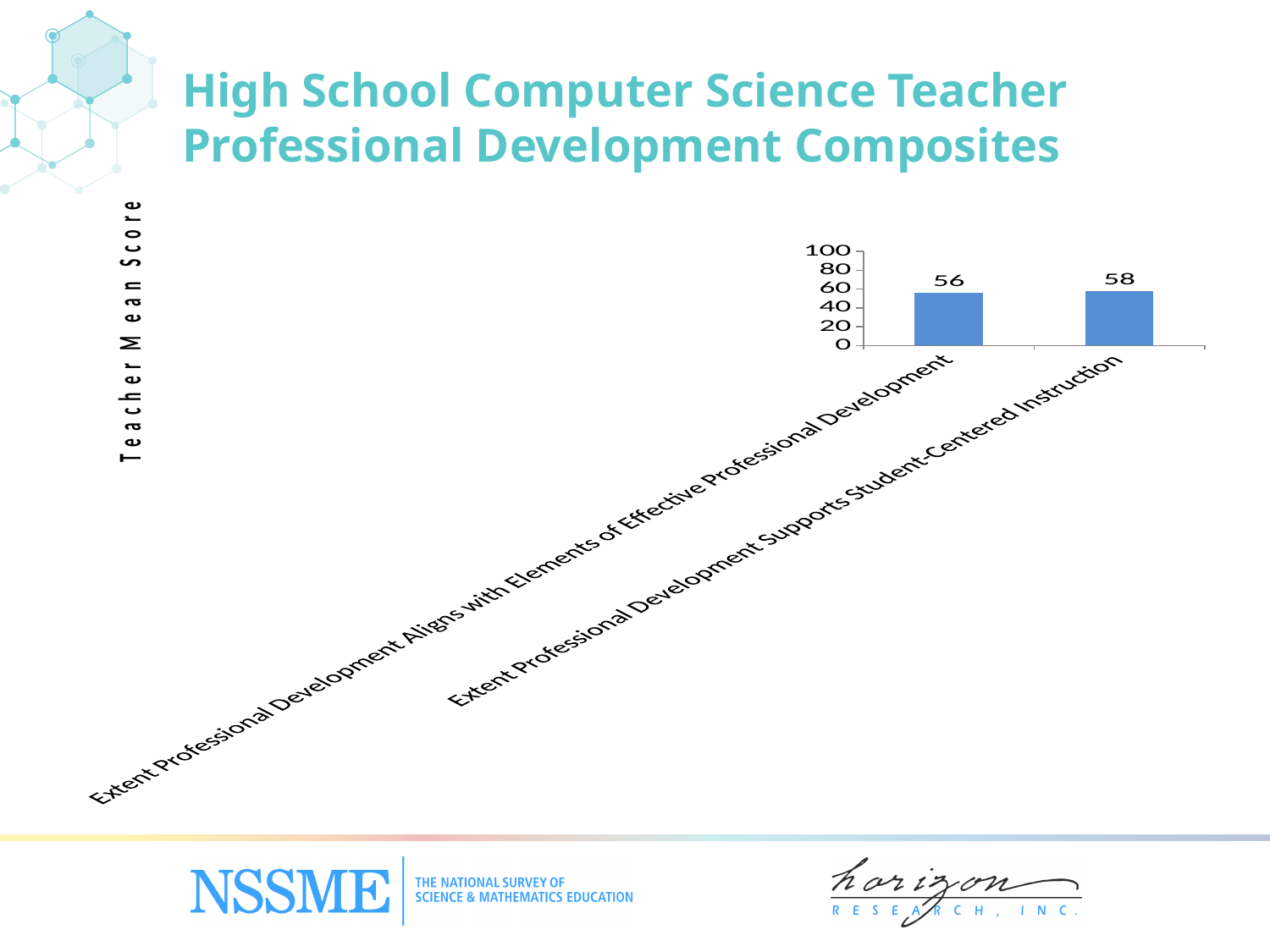
Is the value for 'Extent Professional Development Aligns with Elements of Effective Professional Development' greater or less than 60? less What is the difference between the teacher mean scores of the two composites? 2 What kind of chart is shown on the slide? Bar chart Which composite has the higher teacher mean score? Extent Professional Development Supports Student-Centered Instruction What is the teacher mean score for 'Extent Professional Development Aligns with Elements of Effective Professional Development'? 56 Is the value for 'Extent Professional Development Supports Student-Centered Instruction' greater or less than 40? greater How many composites (categories) are plotted in the chart? 2 Which composite has the lower teacher mean score? Extent Professional Development Aligns with Elements of Effective Professional Development What is the teacher mean score for 'Extent Professional Development Supports Student-Centered Instruction'? 58 What is the maximum value shown on the vertical axis? 100 What is the label of the vertical axis? Teacher Mean Score